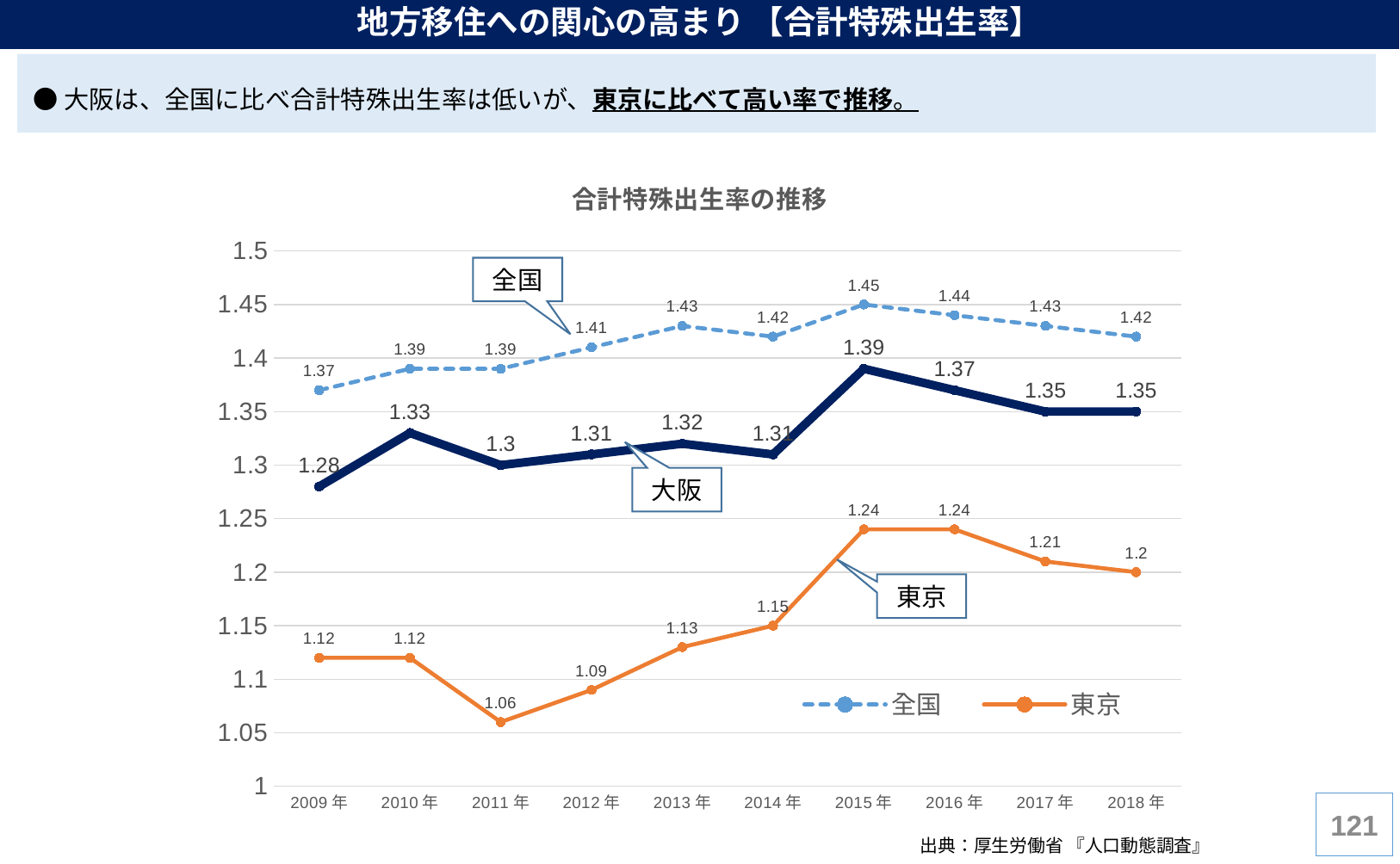
What type of chart is shown on the slide? Line chart How many years are plotted along the x axis? 10 Which is larger in 2018年, the 大阪 value or the 東京 value? 大阪 Does the 東京 line rise or fall from 2011年 to 2015年? Rise What is the value for 大阪 in 2015年? 1.39 What is the value for 全国 in 2018年? 1.42 In which year is the 東京 value lowest? 2011年 How many series does the legend list? 2 What is the title of the chart? 合計特殊出生率の推移 In which year is the 全国 value highest? 2015年 What is the difference between the 全国 and 大阪 values in 2009年? 0.09 What is the value for 東京 in 2011年? 1.06